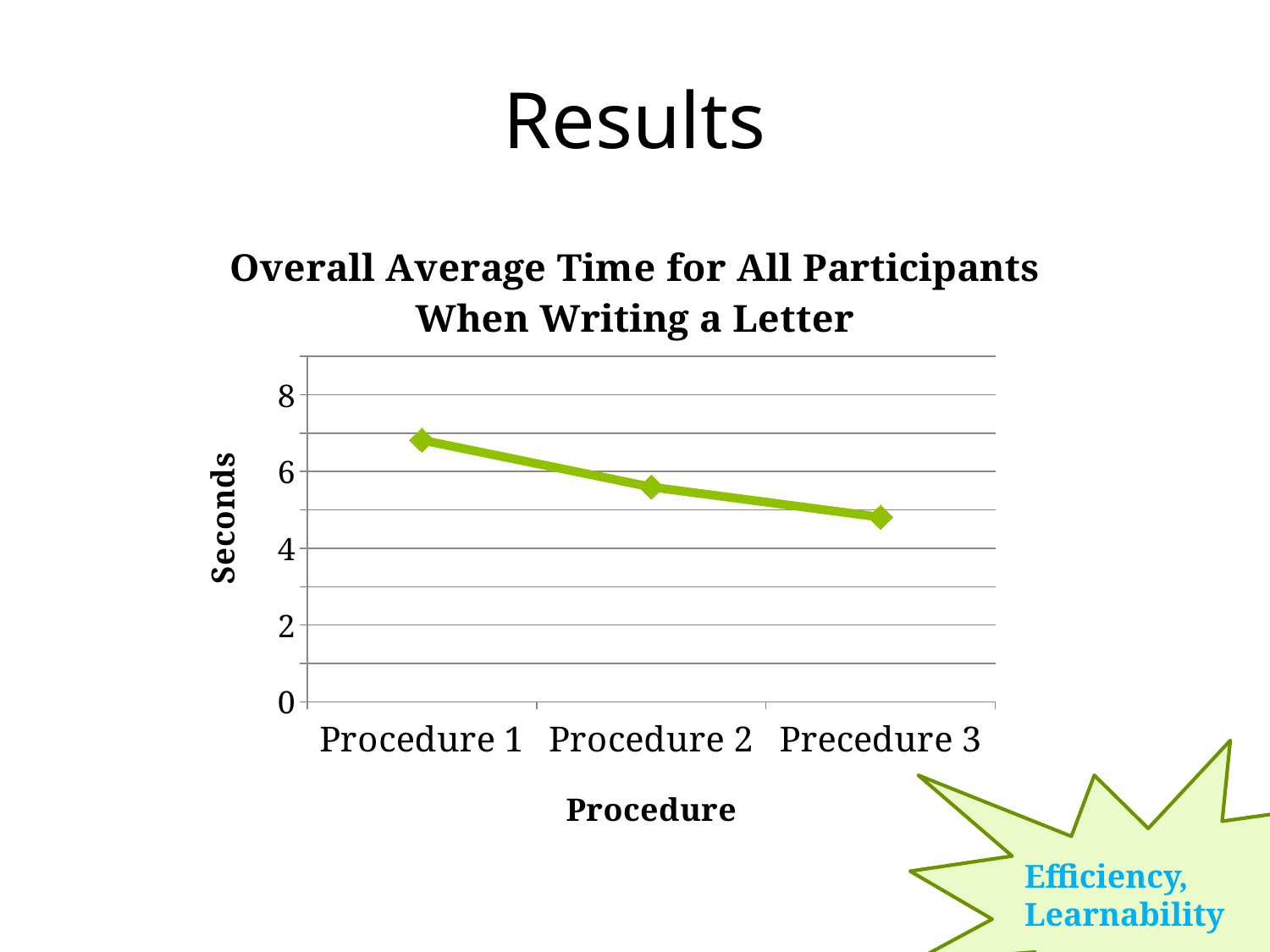
Is the value for Procedure 2 greater or less than 6? less What is the title of the chart? Overall Average Time for All Participants When Writing a Letter Which has a larger average time, Procedure 2 or Precedure 3? Procedure 2 Do the values rise or fall from Procedure 1 to Precedure 3? fall Which procedure has the highest average time? Procedure 1 How many procedures are plotted on the x axis of the chart? 3 What kind of chart is shown on the slide? line chart Is the value for Precedure 3 greater or less than 4? greater Which procedure has the lowest average time? Precedure 3 Is the value for Procedure 1 greater or less than 6? greater What is the label of the vertical axis of the chart? Seconds Which has a larger average time, Procedure 1 or Procedure 2? Procedure 1